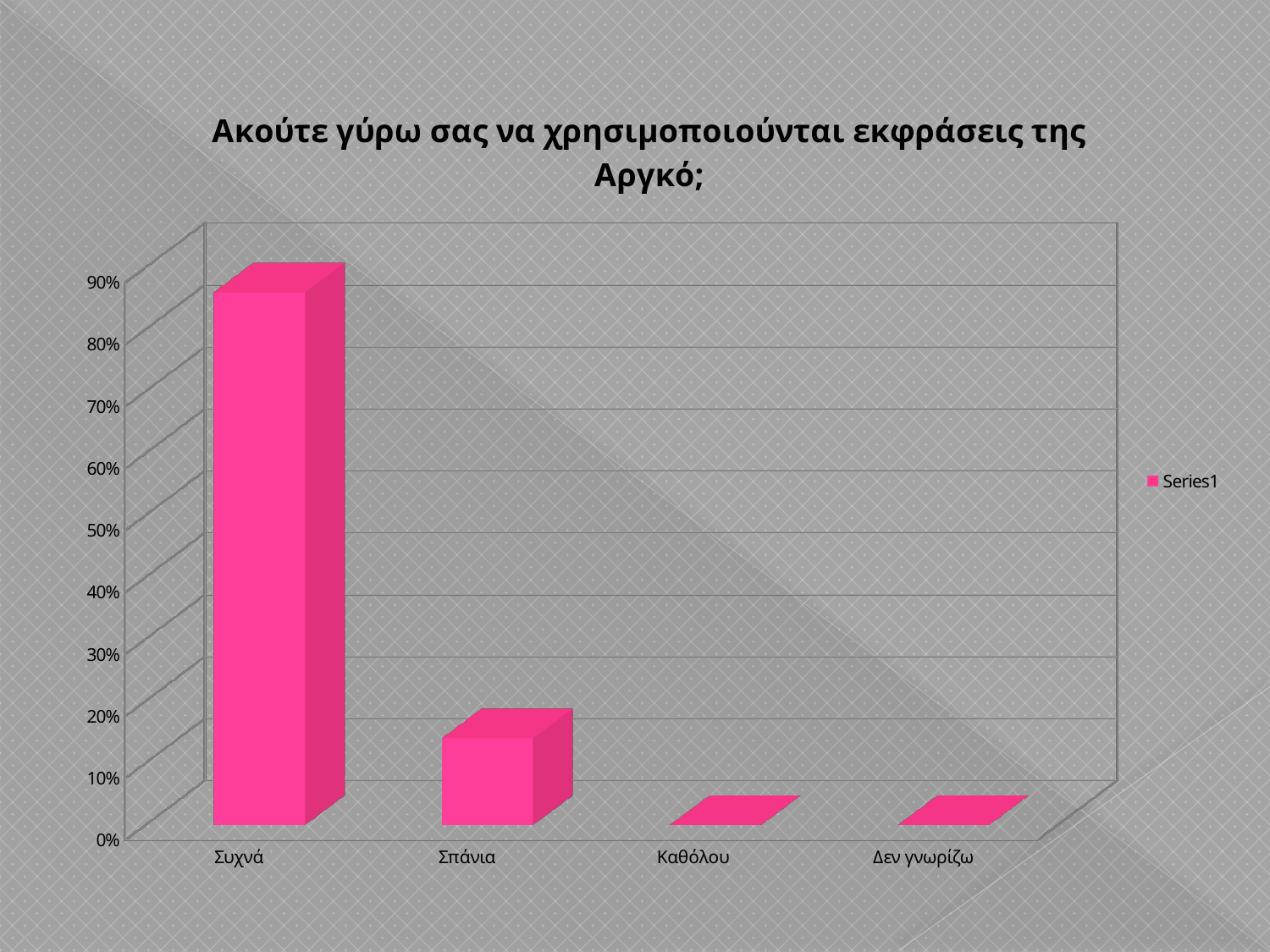
What is the value for Καθόλου? 0% Is the value for Συχνά greater or less than 50%? greater Is the value for Σπάνια greater or less than 10%? greater Is the value for Σπάνια greater or less than 20%? less What kind of chart is shown on the slide? bar chart Which is larger, the value for Συχνά or the value for Σπάνια? Συχνά Which category has the highest value? Συχνά What is the title of the chart? Ακούτε γύρω σας να χρησιμοποιούνται εκφράσεις της Αργκό; What is the name of the series shown in the legend? Series1 How many series does the legend list? 1 How many categories are shown on the x axis of the chart? 4